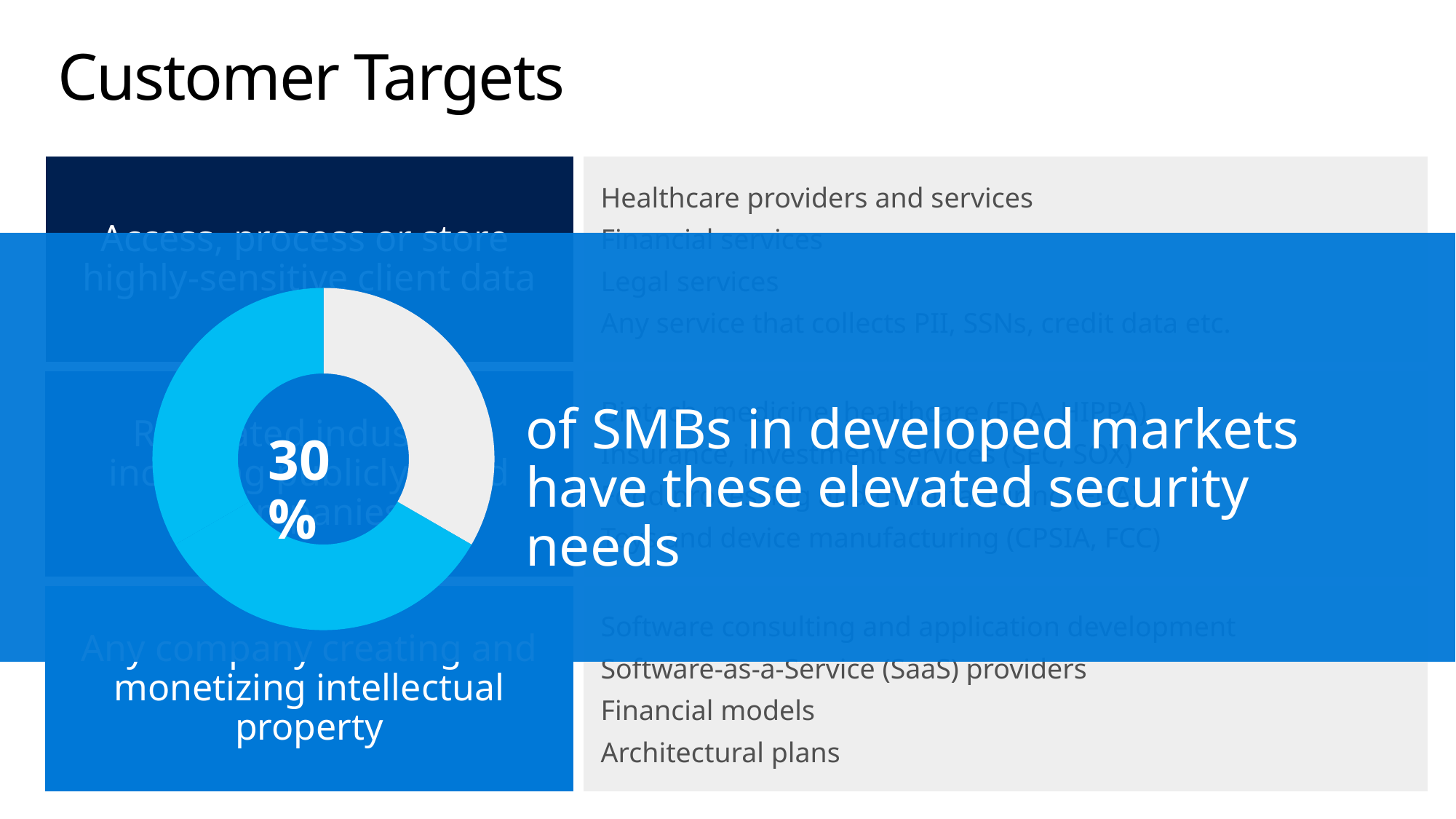
Which segment of the donut chart is larger, the light blue one or the grey one? The light blue one What kind of chart is shown on the slide? Pie chart (donut) What is the title of the slide containing the donut chart? Customer Targets According to the text next to the donut chart, what does the 30% figure represent? SMBs in developed markets that have these elevated security needs Is the percentage shown in the centre of the donut chart greater or less than 50%? less What percentage is printed in the centre of the donut chart? 30%